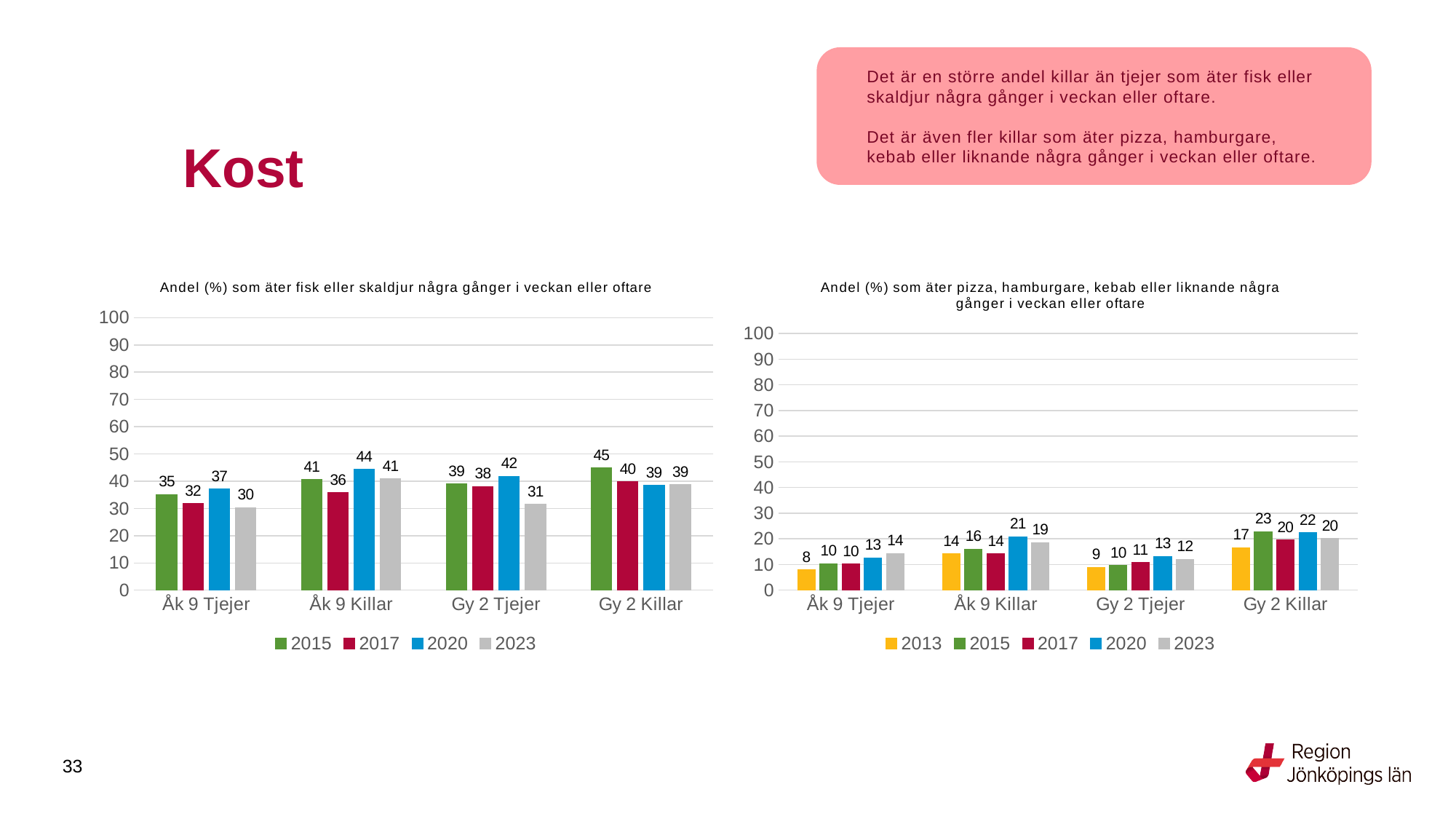
In the right chart (pizza, hamburgare, kebab), which category has the lowest 2023 value? Gy 2 Tjejer In the right chart (pizza, hamburgare, kebab), is the 2020 value for Åk 9 Killar larger or smaller than the 2020 value for Gy 2 Tjejer? larger In the left chart (fisk eller skaldjur), how many series does the legend list? 4 In the right chart (pizza, hamburgare, kebab), what is the value for Gy 2 Killar in 2015? 23 What kind of chart is the left chart (fisk eller skaldjur)? bar chart In the left chart (fisk eller skaldjur), which category has the highest 2015 value? Gy 2 Killar In the left chart (fisk eller skaldjur), what is the value for Åk 9 Killar in 2020? 44 In the right chart (pizza, hamburgare, kebab), how many series does the legend list? 5 In the right chart (pizza, hamburgare, kebab), what is the value for Åk 9 Tjejer in 2013? 8 In the right chart (pizza, hamburgare, kebab), do the values for Åk 9 Tjejer rise or fall from 2013 to 2023? rise In the left chart (fisk eller skaldjur), what is the value for Gy 2 Tjejer in 2023? 31 In the left chart (fisk eller skaldjur), what is the difference between the 2015 and 2023 values for Gy 2 Killar? 6